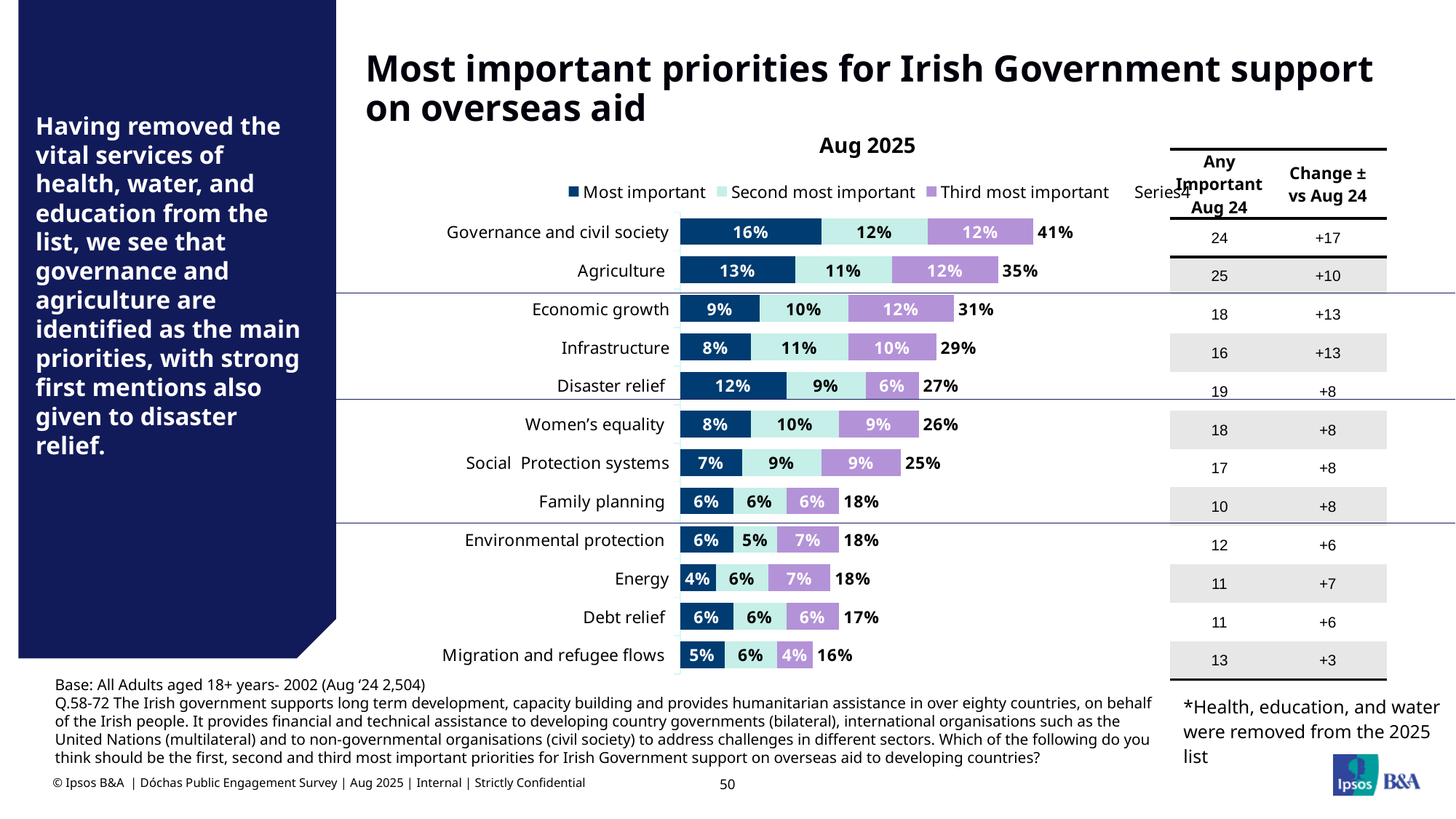
Which category has the highest total across the three stacked segments? Governance and civil society What is the difference between the total for Governance and civil society and the total for Agriculture? 6 percentage points How many categories are plotted in the chart? 12 What kind of chart is shown on the slide? Stacked bar chart What is the 'Most important' value for Energy? 4% What is the 'Second most important' value for Agriculture? 11% What is the 'Most important' value for Governance and civil society? 16% What is the total shown at the end of the stacked bar for Governance and civil society? 41% What is the 'Third most important' value for Disaster relief? 6% Which category has the lowest total across the three stacked segments? Migration and refugee flows What date label appears above the chart legend? Aug 2025 Which has the larger 'Most important' value: Disaster relief or Economic growth? Disaster relief